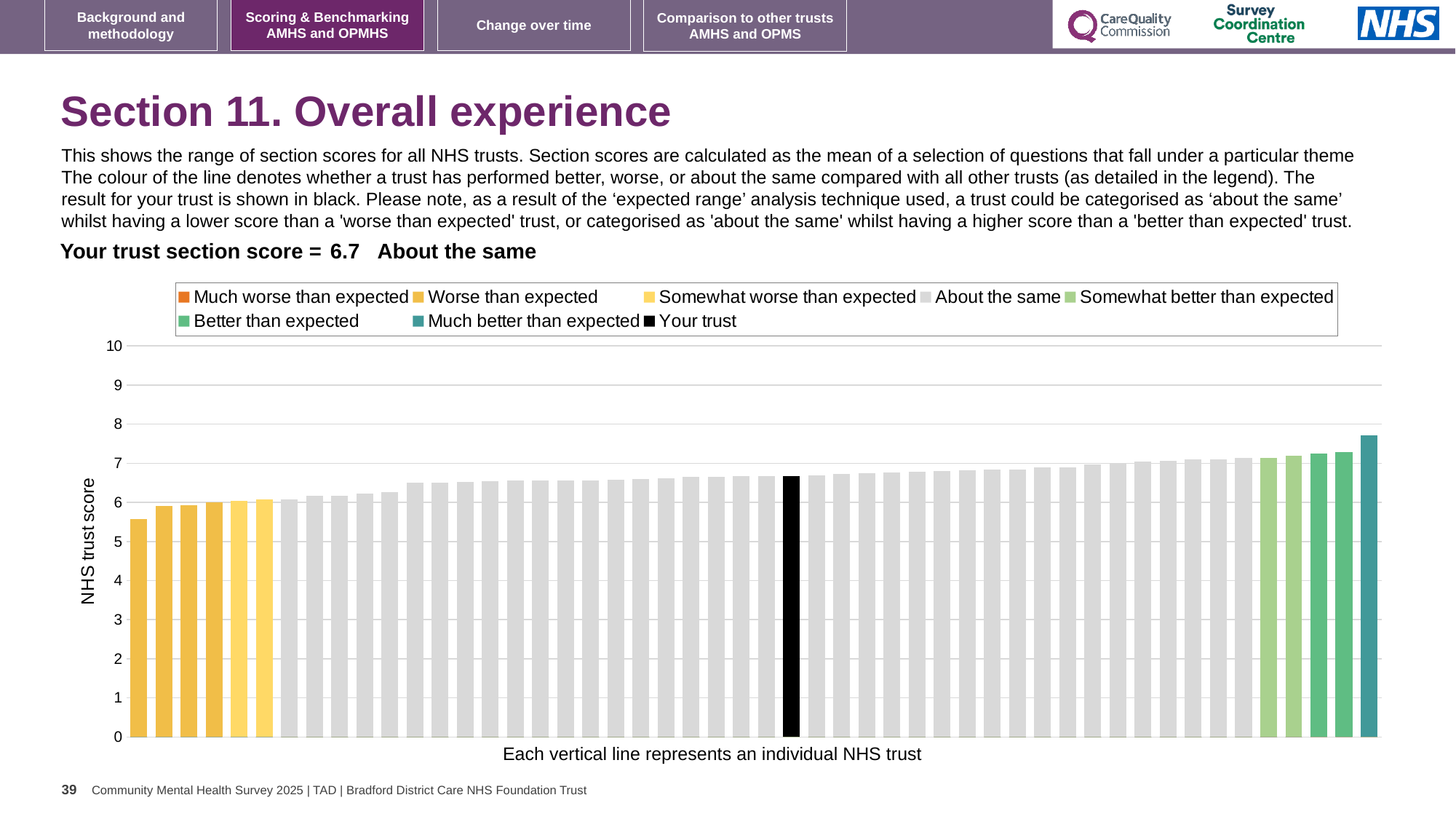
Do the bar values rise or fall moving from left to right along the x axis? Rise What is the maximum value shown on the vertical axis? 10 What type of chart is shown on the slide? Bar chart Which category does your trust fall into according to the text above the chart? About the same Is the value of the rightmost bar greater or less than the value of the black bar? greater Is the value for your trust (the black bar) greater or less than 6? greater What is the label on the vertical axis of the chart? NHS trust score Is the value of the tallest bar (rightmost) greater or less than 7? greater Is the value of the leftmost bar greater or less than 5? greater What is the section score for your trust, as printed on the slide? 6.7 How many entries does the chart legend list? 8